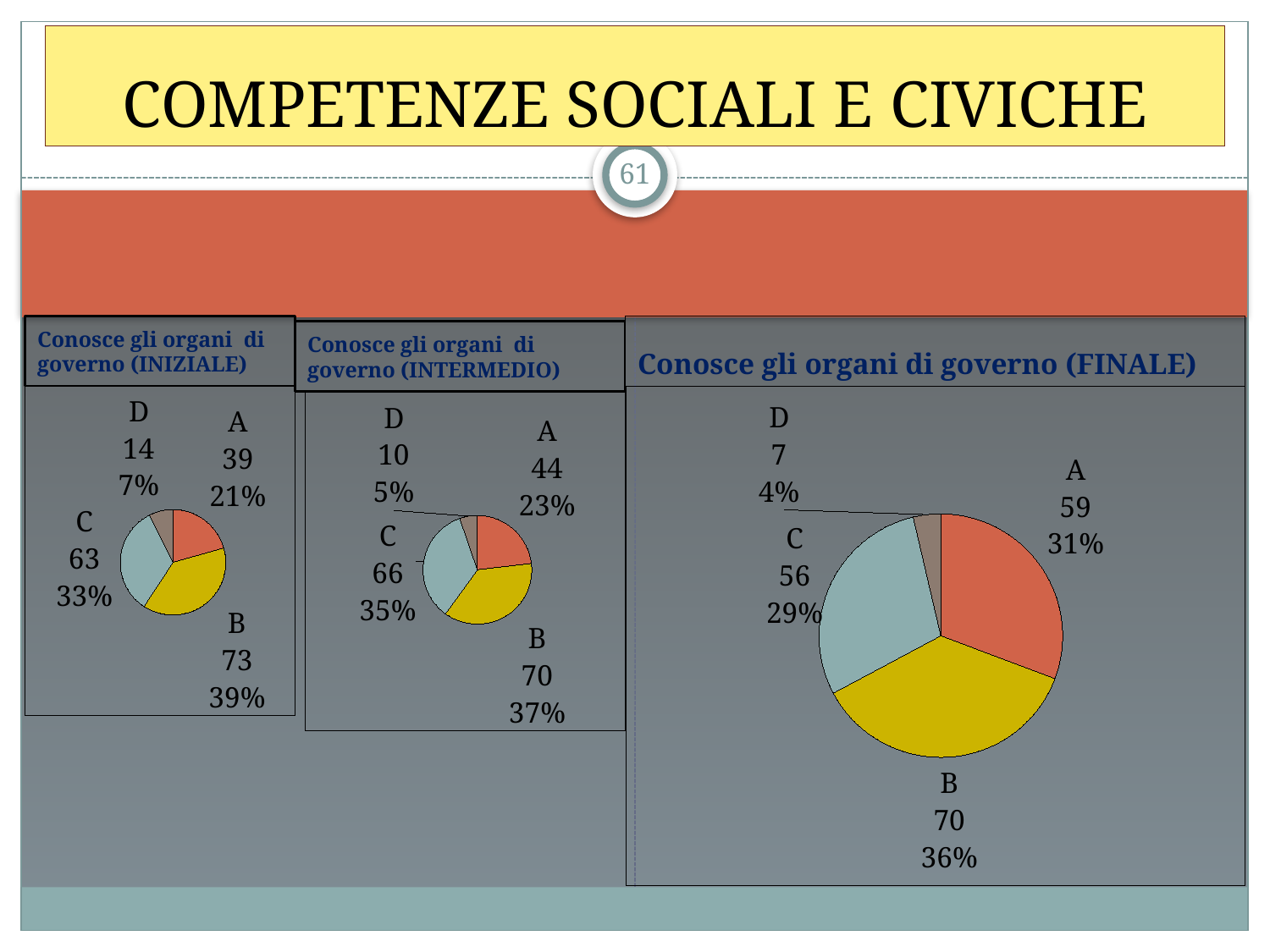
In the 'Conosce gli organi di governo (FINALE)' chart, which is larger, the value for A or the value for C? A How many pie charts are shown on the slide? 3 In the 'Conosce gli organi di governo (INIZIALE)' chart, which category has the smallest value? D In the 'Conosce gli organi di governo (INIZIALE)' chart, what is the value for category B? 73 In the 'Conosce gli organi di governo (FINALE)' chart, what share of the pie does category C represent? 29% In the 'Conosce gli organi di governo (INTERMEDIO)' chart, what is the value for category C? 66 In the 'Conosce gli organi di governo (INTERMEDIO)' chart, what is the difference between the values for B and A? 26 In the 'Conosce gli organi di governo (FINALE)' chart, what is the value for category A? 59 In the 'Conosce gli organi di governo (INTERMEDIO)' chart, what percentage is shown for category D? 5% In the 'Conosce gli organi di governo (FINALE)' chart, which category has the largest value? B What kind of chart is 'Conosce gli organi di governo (FINALE)'? Pie chart How many categories are shown in the 'Conosce gli organi di governo (INIZIALE)' chart? 4